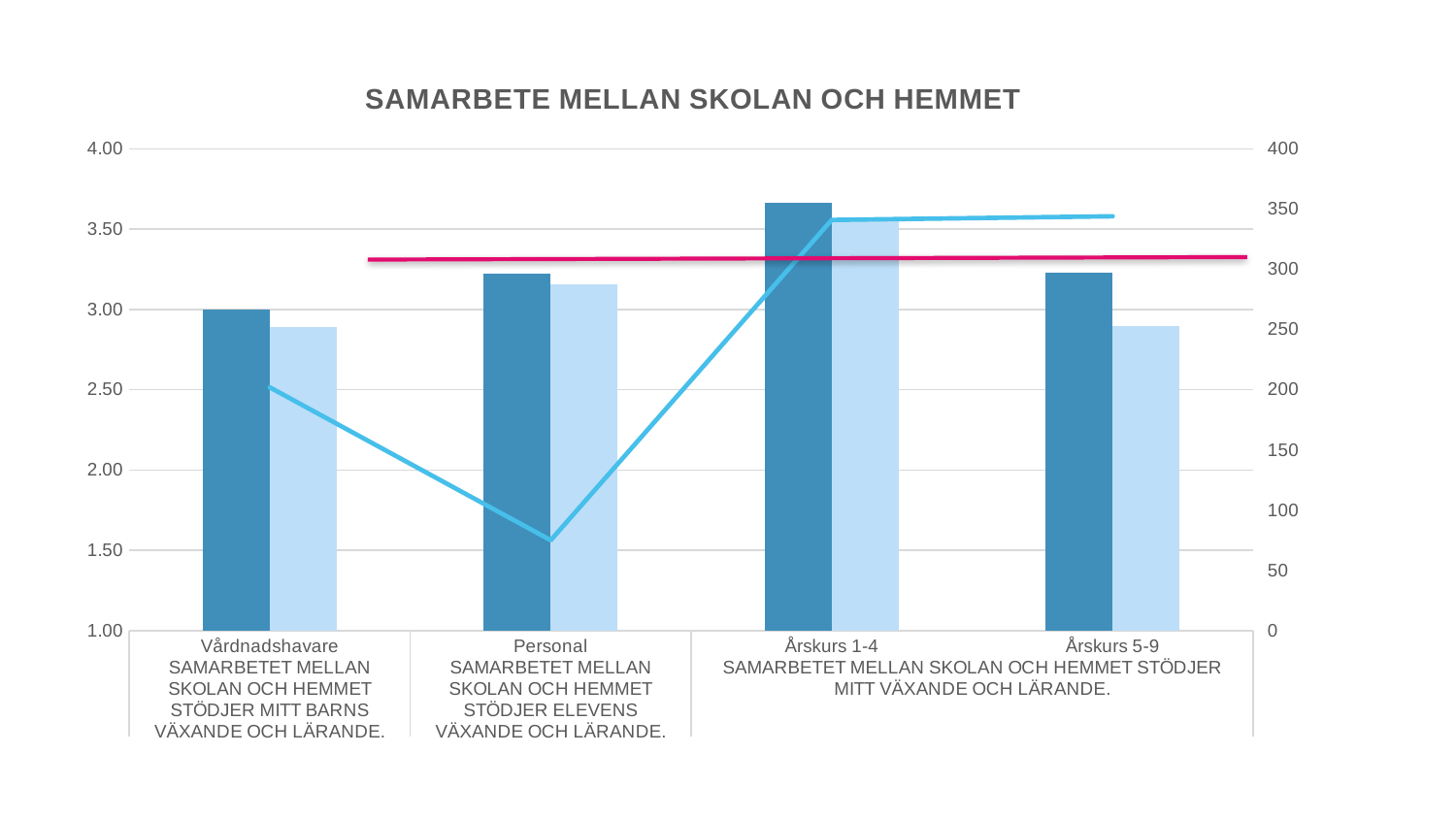
Is the light blue line value for Årskurs 1-4 greater or less than 300 on the right axis? greater What is the title of the chart? SAMARBETE MELLAN SKOLAN OCH HEMMET Is the light blue line value for Personal greater or less than 100 on the right axis? less Is the dark blue bar for Årskurs 1-4 greater or less than 3.50 on the left axis? greater Which is larger, the dark blue bar for Personal or the dark blue bar for Vårdnadshavare? Personal What kind of chart is shown on the slide? A combination bar and line chart Which category has the tallest dark blue bar? Årskurs 1-4 Which category has the shortest dark blue bar? Vårdnadshavare How many categories are shown along the x axis? 4 Which category has the tallest light blue bar? Årskurs 1-4 Does the light blue line rise or fall between Personal and Årskurs 1-4? rise